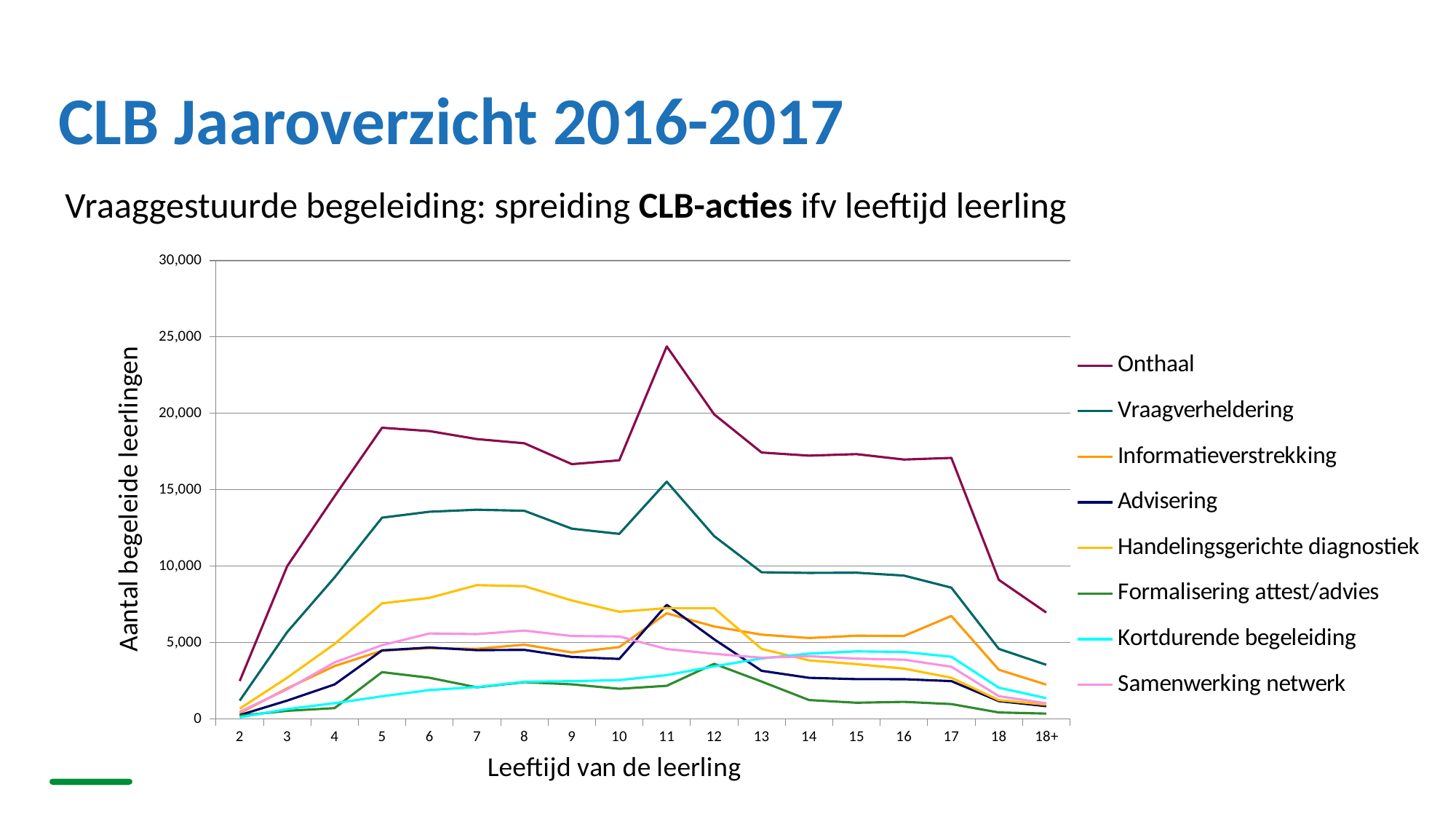
Which is larger: Onthaal at age 5 or Onthaal at age 18? Onthaal at age 5 What kind of chart is shown on the slide? line chart How many series does the legend list? 8 Is the value for Onthaal at age 11 greater or less than 20,000? greater What is the title of the y axis? Aantal begeleide leerlingen Which series has the lowest value at age 18+? Formalisering attest/advies How many age categories are shown on the x axis? 18 Is the value for Onthaal at age 18+ greater or less than 10,000? less At which age does the Onthaal series reach its highest value? 11 Is the value for Handelingsgerichte diagnostiek at age 7 greater or less than 5,000? greater Does the Onthaal series rise or fall from age 17 to age 18+? fall Which series has the highest values across the chart? Onthaal